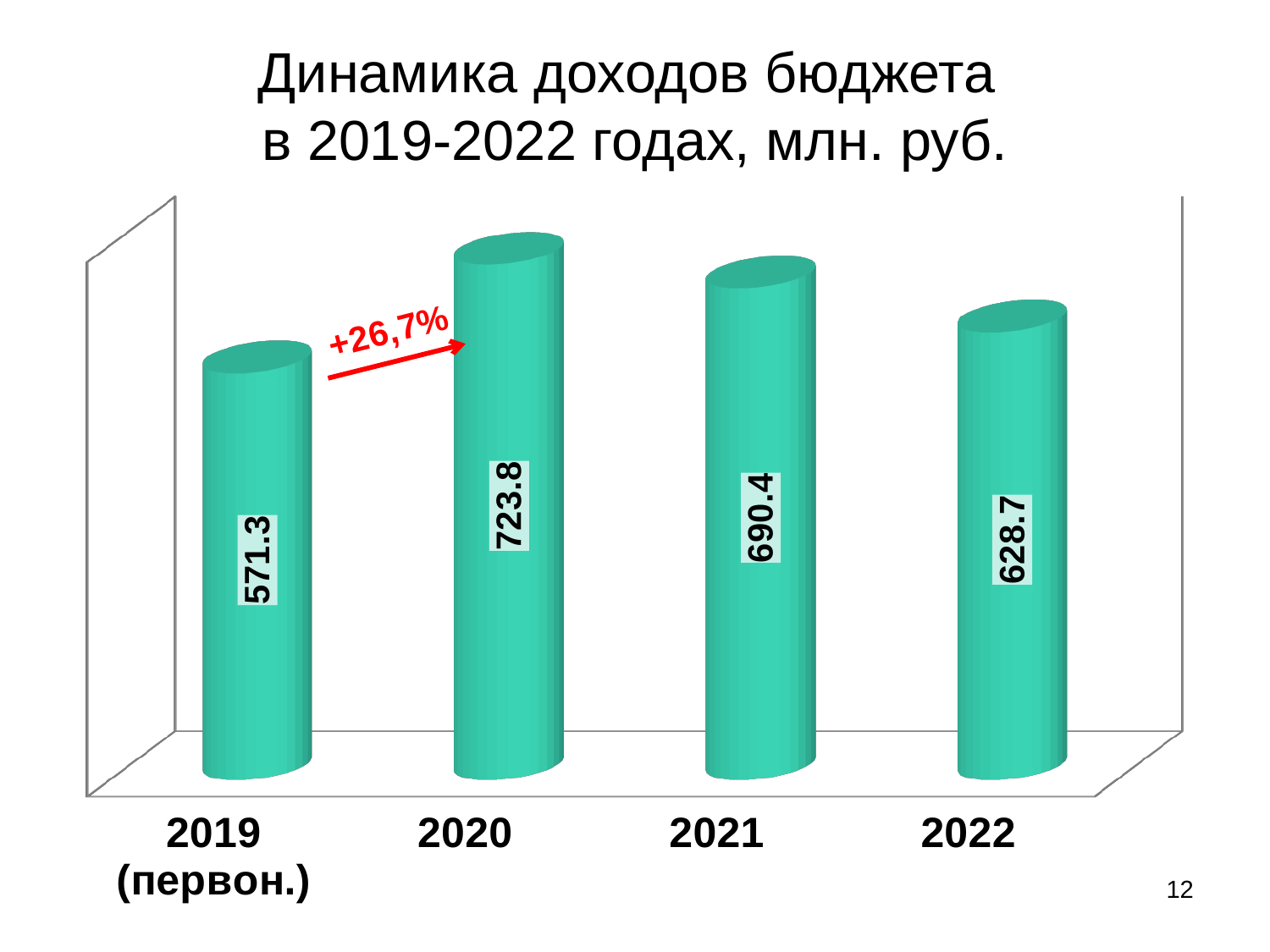
Which is larger, the value for 2021 or the value for 2022? 2021 Which year has the highest budget revenue? 2020 What percentage change is annotated by the red arrow between 2019 and 2020? +26,7% What is the budget revenue value shown for 2020? 723.8 What is the difference between the values for 2021 and 2022? 61.7 What kind of chart is shown on the slide? Bar chart How many years are shown on the chart? 4 What is the value shown for 2022? 628.7 What is the value shown for 2019 (первон.)? 571.3 Do the values rise or fall from 2020 to 2022? Fall Which year has the lowest budget revenue? 2019 (первон.) What is the difference between the values for 2020 and 2019 (первон.)? 152.5